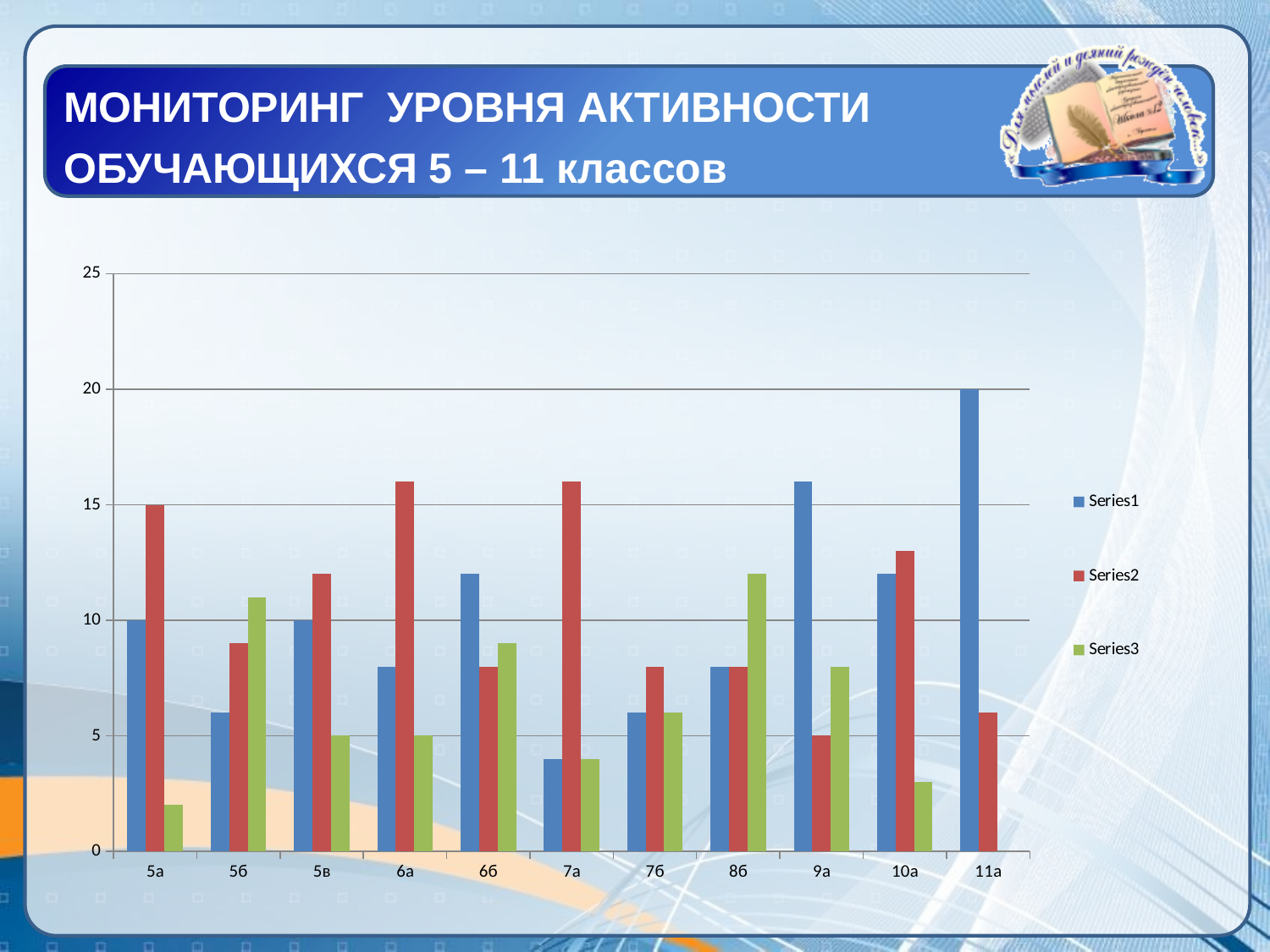
Which category has the lowest Series1 value? 7а How many class categories are shown on the x axis? 11 Is the value of Series3 for 10а greater or less than 5? less What is the value of Series1 for 5а? 10 How many series does the legend list? 3 What type of chart is shown on the slide? bar chart For 5а, which is larger: Series1 or Series2? Series2 Which category has the highest Series1 value? 11а Is the value of Series2 for 6а greater or less than 15? greater What is the value of Series2 for 5а? 15 Which category has the highest Series3 value? 8б What is the value of Series1 for 11а? 20